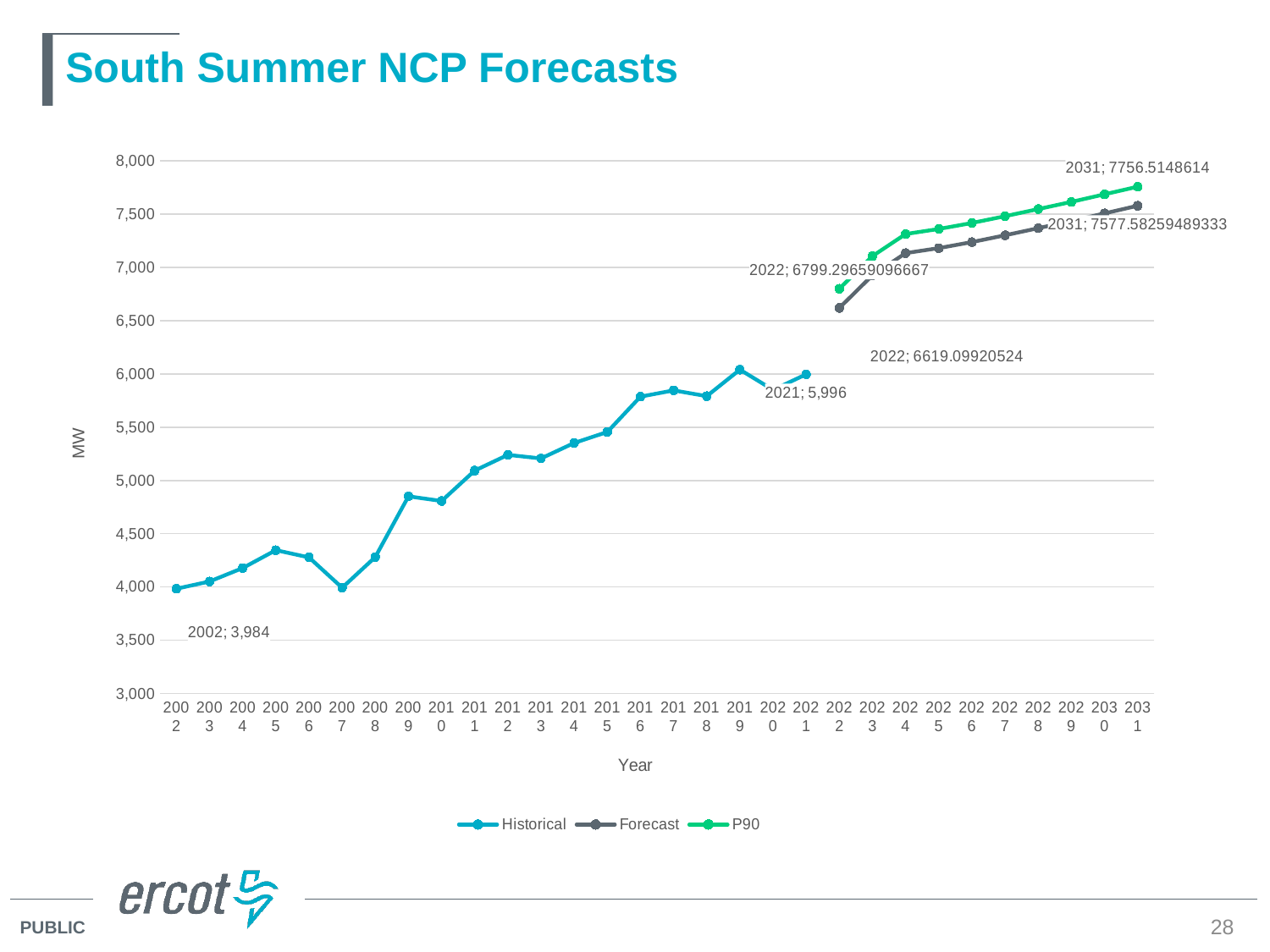
What is the Historical value for 2002? 3,984 What is the Historical value for 2021? 5,996 Which is larger in 2031, the P90 value or the Forecast value? P90 What is the label of the y axis? MW What is the P90 value for 2031? 7756.5148614 What is the difference between the Historical values for 2021 and 2002? 2,012 What kind of chart is shown on the slide? line chart What is the P90 value for 2022? 6799.29659096667 What is the Forecast value for 2031? 7577.58259489333 How many series does the legend list? 3 What is the Forecast value for 2022? 6619.09920524